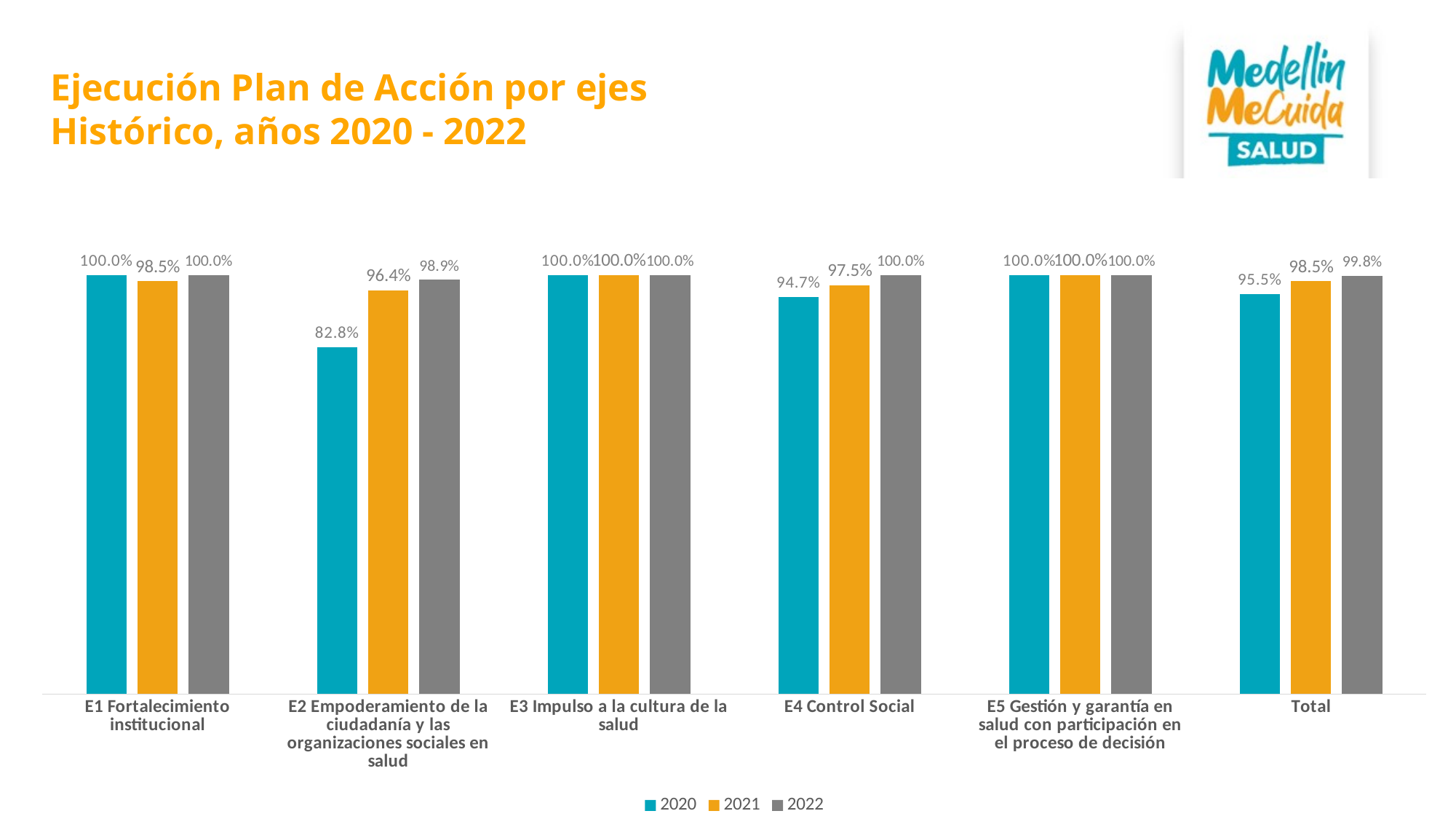
What is the Total value for 2022? 99.8% What is the difference between the 2021 and 2020 values for E4 Control Social? 2.8% How many categories are shown on the x axis? 6 Which category has the lowest value in the 2020 series? E2 Empoderamiento de la ciudadanía y las organizaciones sociales en salud What is the value for E4 Control Social in 2020? 94.7% Do the Total values rise or fall from 2020 to 2022? Rise How many series does the legend list? 3 Which is larger for Total: the 2020 value or the 2021 value? 2021 What is the value for E1 Fortalecimiento institucional in 2021? 98.5% What is the 2021 value for E2 Empoderamiento de la ciudadanía y las organizaciones sociales en salud? 96.4% What is the difference between the 2022 and 2020 values for E2 Empoderamiento de la ciudadanía y las organizaciones sociales en salud? 16.1% What kind of chart is shown on the slide? Bar chart